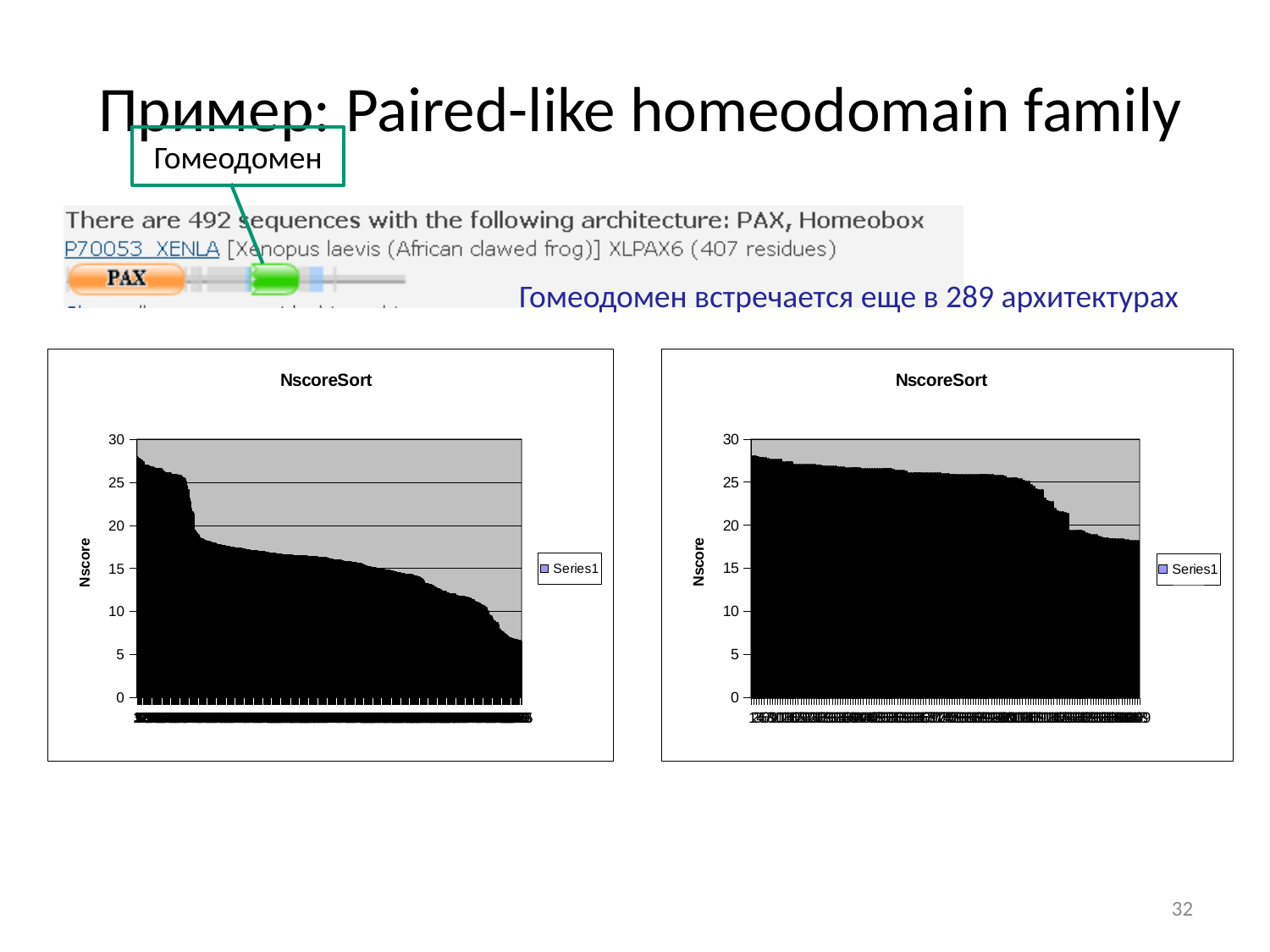
What is the title of the y axis on the left chart? Nscore In the right NscoreSort chart, do the values rise or fall from left to right along the x axis? fall What is the legend entry shown in the right chart? Series1 In the right NscoreSort chart, is the value of the rightmost bar greater or less than 15? greater In the left NscoreSort chart, is the value of the leftmost bar greater or less than 25? greater In the right NscoreSort chart, is the value of the leftmost bar greater or less than 30? less In the left NscoreSort chart, do the values rise or fall from left to right along the x axis? fall What kind of chart is the left chart titled NscoreSort? bar chart How many series does the legend of the right NscoreSort chart list? 1